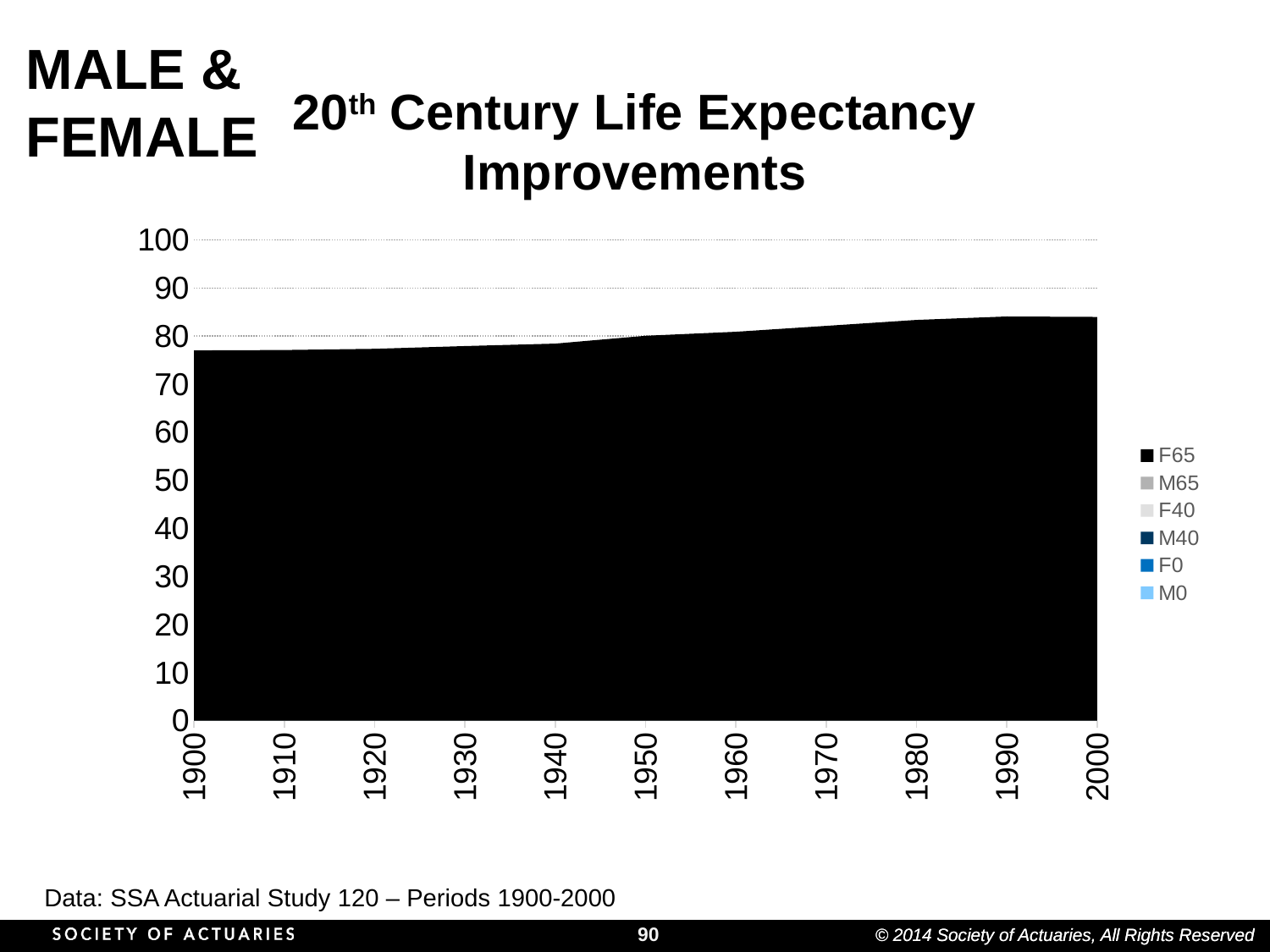
How many series does the legend list? 6 Is the value for F65 in 1950 greater or less than 70? greater Which year has the higher F65 value, 1900 or 2000? 2000 Which series is drawn in black on the chart? F65 What kind of chart is shown on the slide? Area chart How many year labels are shown along the x axis? 11 What is the title of the chart? 20th Century Life Expectancy Improvements Is the value for F65 in 2000 greater or less than 90? less Does the F65 series rise or fall from 1900 to 2000? Rise What is the first year shown on the x axis? 1900 Is the value for F65 in 1900 greater or less than 80? less